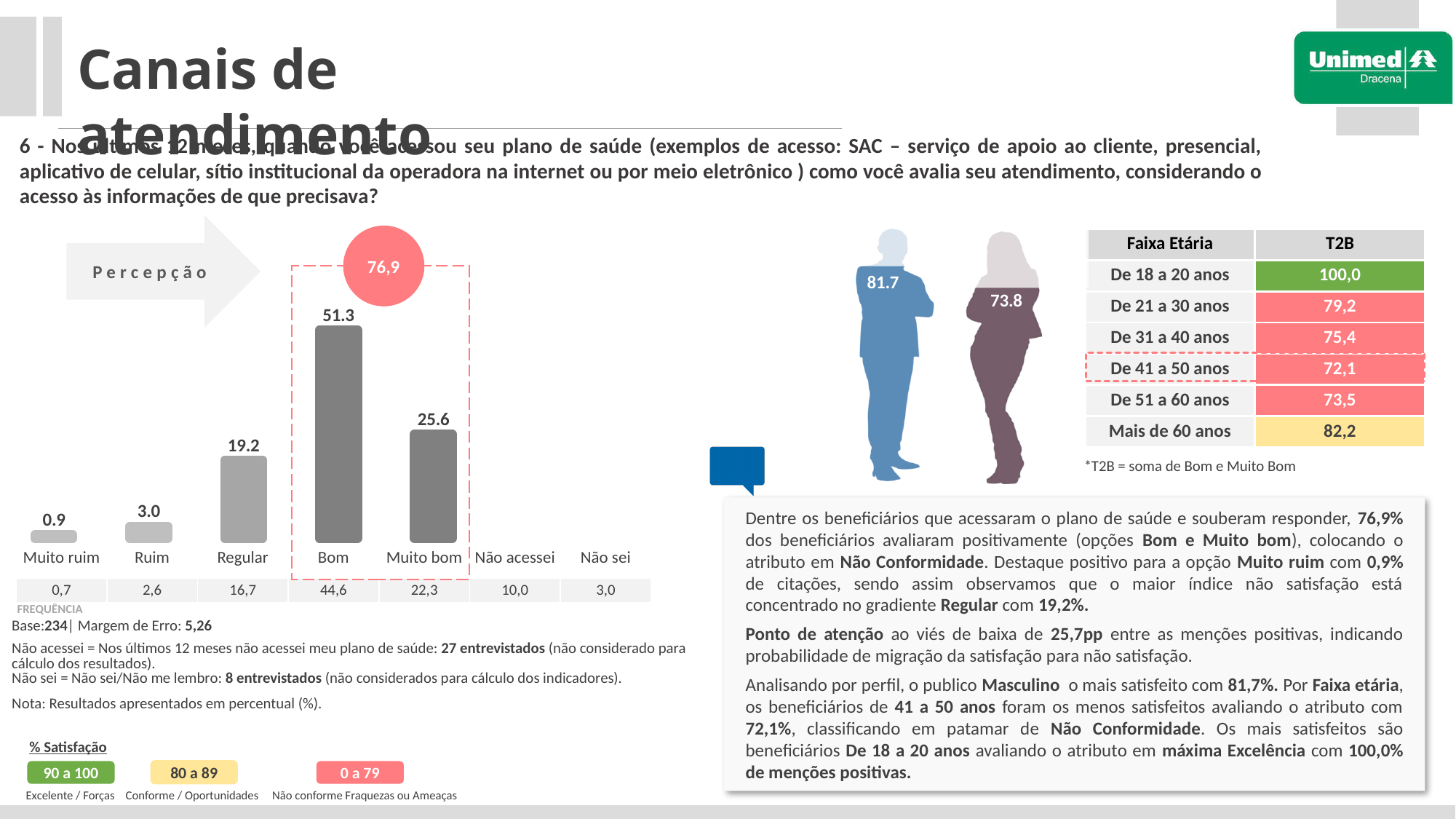
What is the difference between the 'Bom' and 'Muito bom' values? 25.7 What is the value shown for 'Ruim' in the chart? 3.0 What is the combined value of 'Bom' and 'Muito bom' shown in the pink circle above the chart? 76,9 What is the value shown for the 'Muito bom' bar? 25.6 What is the value shown for the 'Muito ruim' bar? 0.9 Which category has the lowest bar in the chart? Muito ruim Which is larger, the value for 'Regular' or the value for 'Muito bom'? Muito bom Which category has the highest bar in the chart? Bom What type of chart is used to show the evaluation of the service channels? bar chart What is the value shown for the 'Bom' bar? 51.3 How many categories have a bar plotted in the chart? 5 What is the value shown for the 'Regular' bar? 19.2